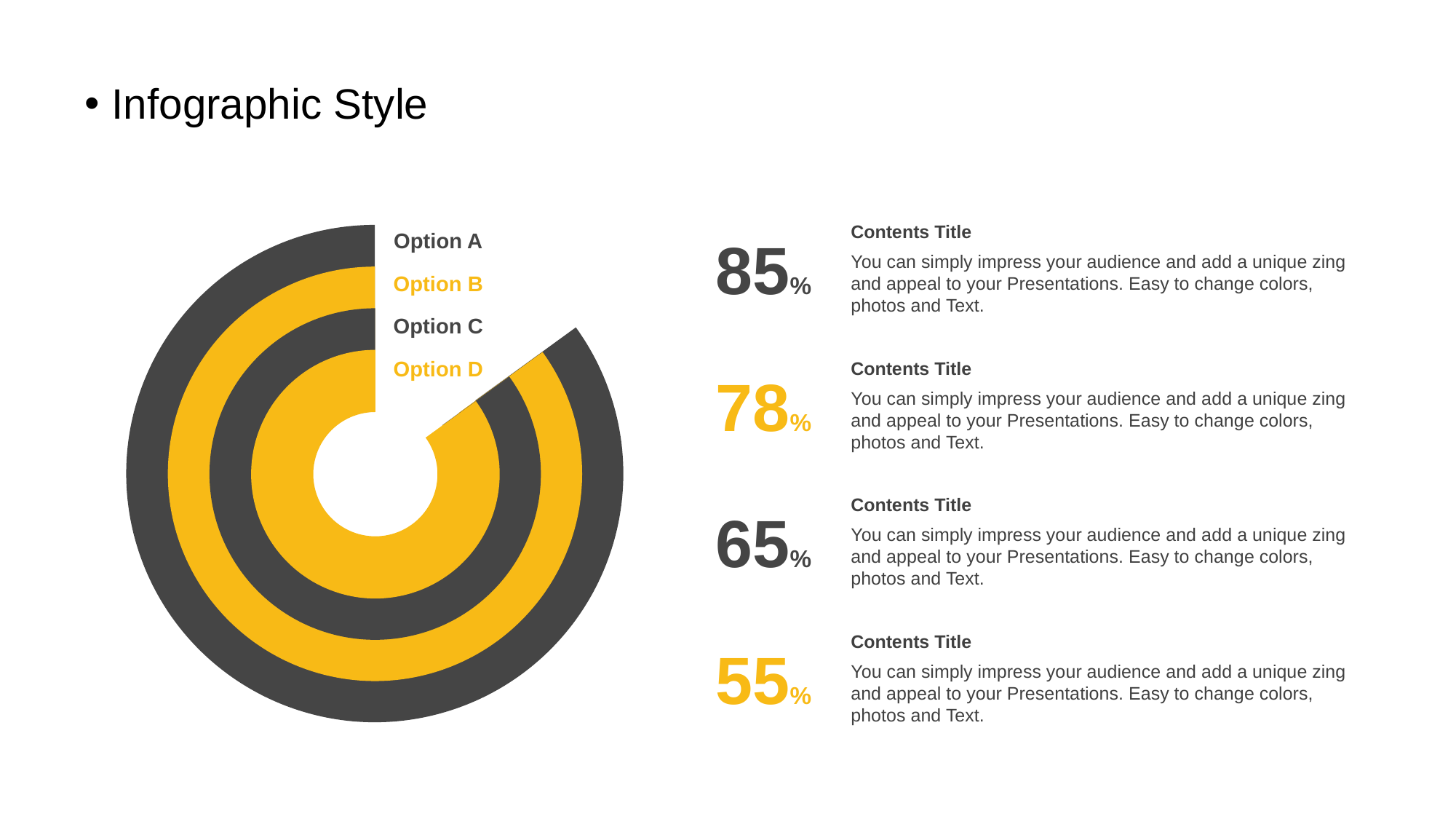
Which option is represented by the innermost ring of the chart? Option D Which option is represented by the outermost ring of the chart? Option A What kind of chart is shown on the slide? Doughnut chart How many rings (options) does the chart have? 4 What colour is the ring for Option B? Yellow Which percentage value listed beside the chart is the lowest? 55% Which is larger among the percentages listed beside the chart, 78% or 65%? 78% Which percentage value listed beside the chart is the highest? 85% What is the difference between the highest and lowest percentage values listed beside the chart? 30% How many percentage values are listed to the right of the chart? 4